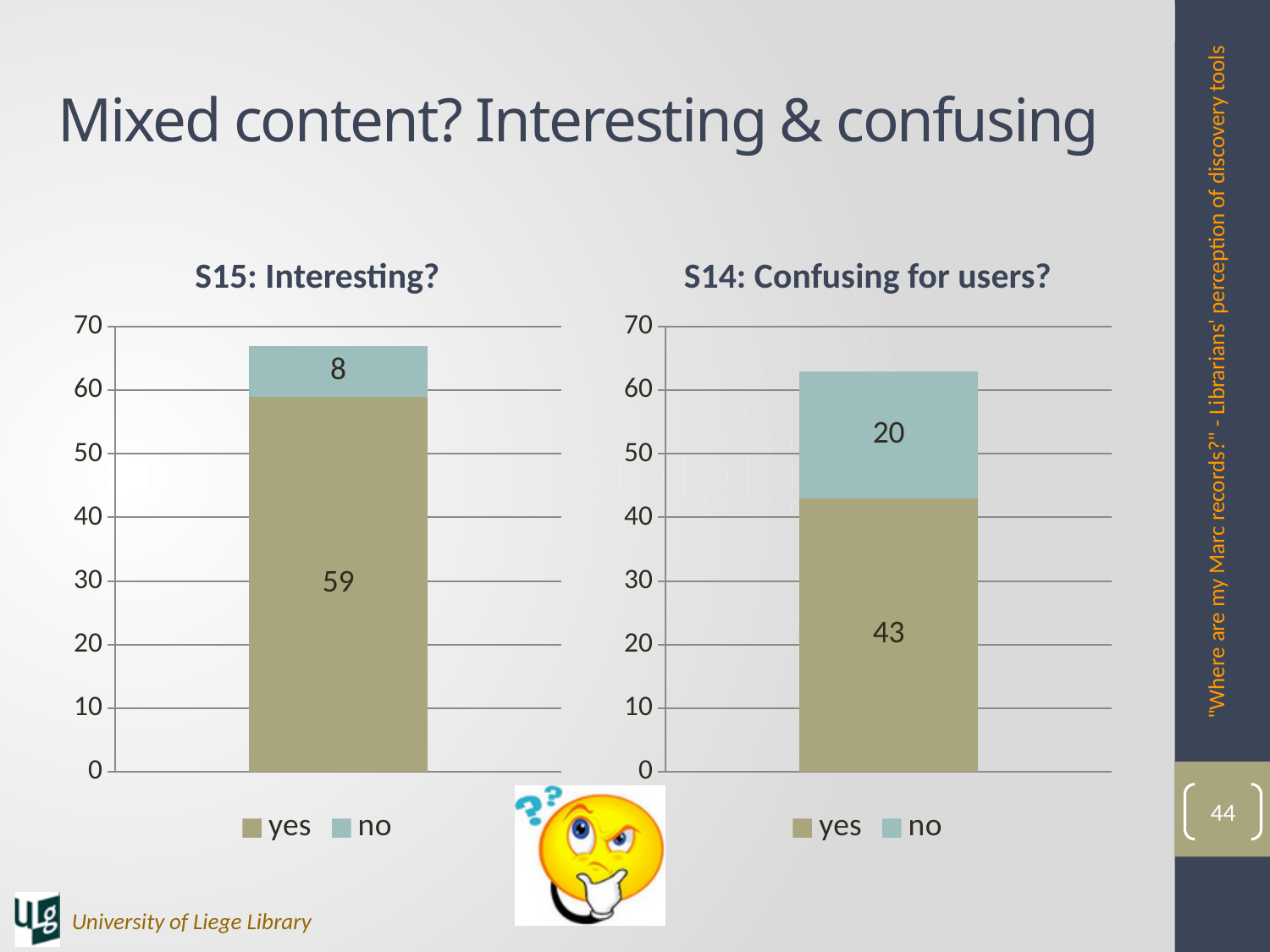
What kind of chart is 'S14: Confusing for users?'? Stacked bar chart In the 'S14: Confusing for users?' chart, what is the difference between the 'yes' and 'no' values? 23 In the 'S14: Confusing for users?' chart, what is the value for 'no'? 20 How many series does the legend of the 'S15: Interesting?' chart list? 2 In the 'S14: Confusing for users?' chart, what is the value for 'yes'? 43 In the 'S14: Confusing for users?' chart, what is the total of the stacked bar? 63 In the 'S15: Interesting?' chart, which colour represents 'no'? Light blue In the 'S15: Interesting?' chart, what is the difference between the 'yes' and 'no' values? 51 In the 'S15: Interesting?' chart, what is the value for 'yes'? 59 In the 'S15: Interesting?' chart, what is the value for 'no'? 8 In the 'S14: Confusing for users?' chart, which series has the larger value, 'yes' or 'no'? yes In the 'S15: Interesting?' chart, what is the total of the stacked bar? 67